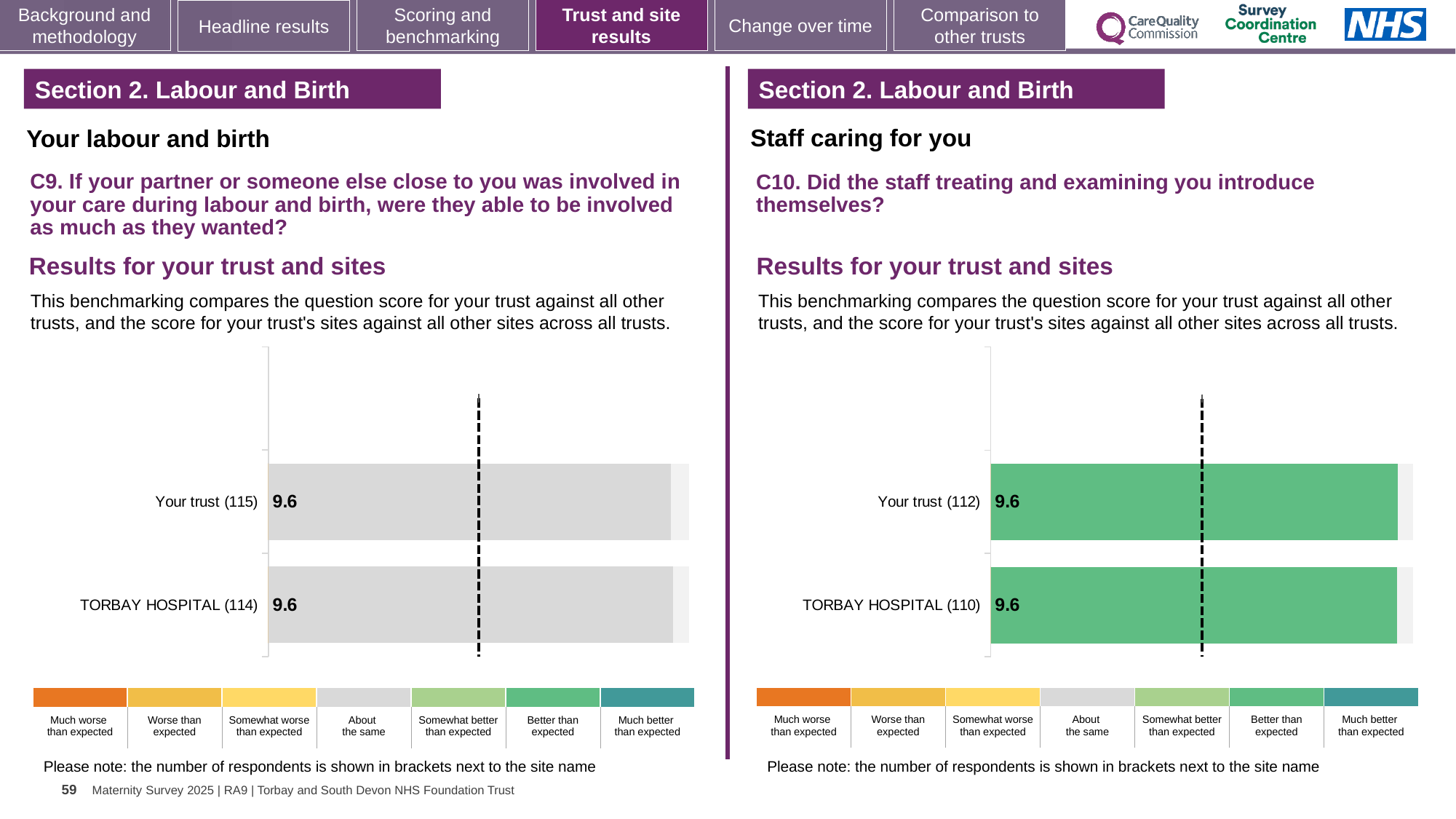
In the C9 chart on the left, what is the score for Your trust? 9.6 How many respondents are shown in brackets for Your trust in the C10 chart on the right? 112 In the C10 chart on the right, what is the score for Your trust? 9.6 In the C10 chart on the right, what is the score for TORBAY HOSPITAL? 9.6 How many bars are plotted in the C10 chart on the right? 2 In the C10 chart on the right, which benchmarking category does the colour of the bars correspond to according to the legend? Better than expected In the C10 chart on the right, what is the difference between the score for Your trust and the score for TORBAY HOSPITAL? 0.0 What kind of chart is used in the C9 chart on the left? Bar chart In the C9 chart on the left, what is the difference between the score for Your trust and the score for TORBAY HOSPITAL? 0.0 How many bars are plotted in the C9 chart on the left? 2 In the C9 chart on the left, what is the score for TORBAY HOSPITAL? 9.6 In the C9 chart on the left, which benchmarking category does the colour of the bars correspond to according to the legend? About the same